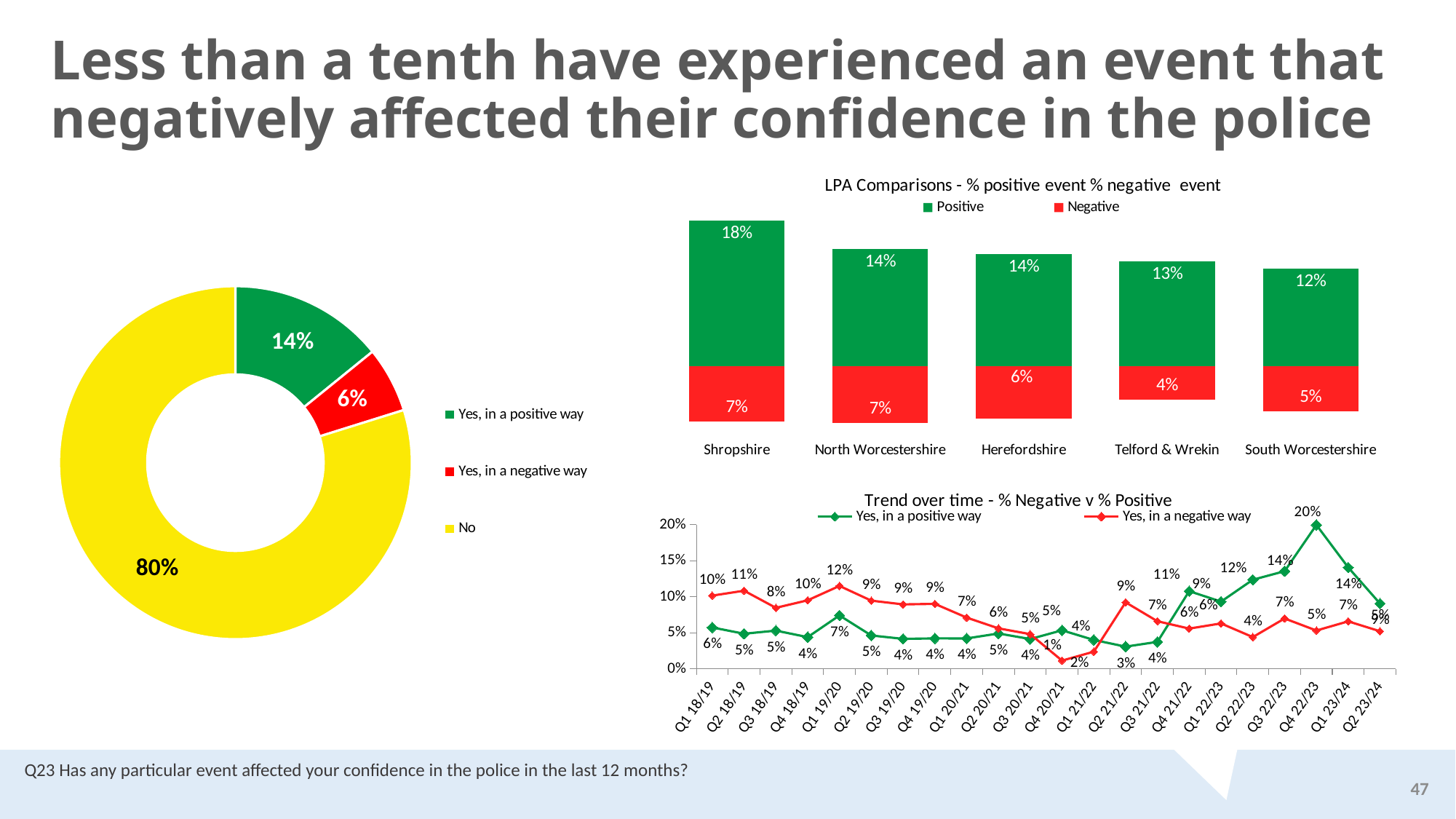
In the 'Trend over time' chart, what is the 'Yes, in a negative way' value at Q1 19/20? 12% In the 'Trend over time' chart, at which quarter does 'Yes, in a positive way' reach its highest value? Q4 22/23 In the doughnut chart on the left, what share of respondents answered 'No'? 80% How many series does the legend of the 'Trend over time' chart list? 2 In the 'LPA Comparisons' chart, what is the Positive value for Shropshire? 18% In the 'LPA Comparisons' chart, what is the difference between the Positive values for Shropshire and South Worcestershire? 6% In the 'LPA Comparisons' chart, how many LPAs are shown? 5 In the 'LPA Comparisons' chart, what is the total of the stacked bar for Shropshire? 25% What kind of chart is the 'LPA Comparisons' chart? Stacked bar chart In the doughnut chart on the left, what percentage answered 'Yes, in a negative way'? 6% How many categories does the doughnut chart on the left show? 3 In the 'LPA Comparisons' chart, which LPA has the lowest Negative value? Telford & Wrekin